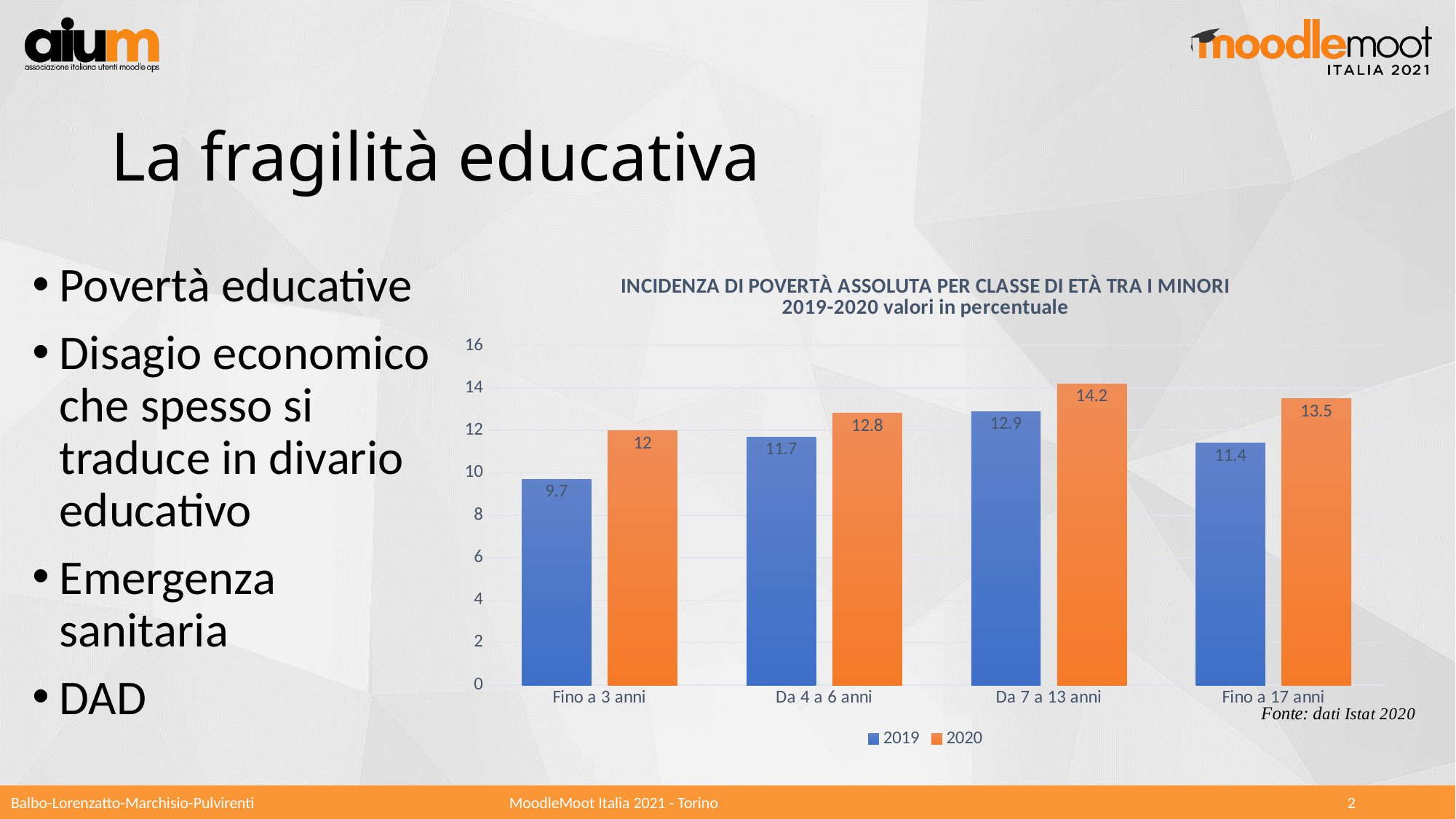
What kind of chart is shown on the slide? Bar chart Which age class has the lowest 2019 value? Fino a 3 anni Which is larger for 'Fino a 17 anni': the 2019 value or the 2020 value? 2020 Which age class has the highest 2020 value? Da 7 a 13 anni What is the difference between the 2020 and 2019 values for 'Da 4 a 6 anni'? 1.1 Which colour represents the 2020 series? Orange What is the 2020 value for 'Fino a 17 anni'? 13.5 How many age classes are shown on the x axis? 4 What is the 2019 value for 'Fino a 3 anni'? 9.7 How many series does the legend list? 2 Is the 2019 value for 'Da 7 a 13 anni' greater or less than 12? greater What is the 2020 value for 'Da 7 a 13 anni'? 14.2